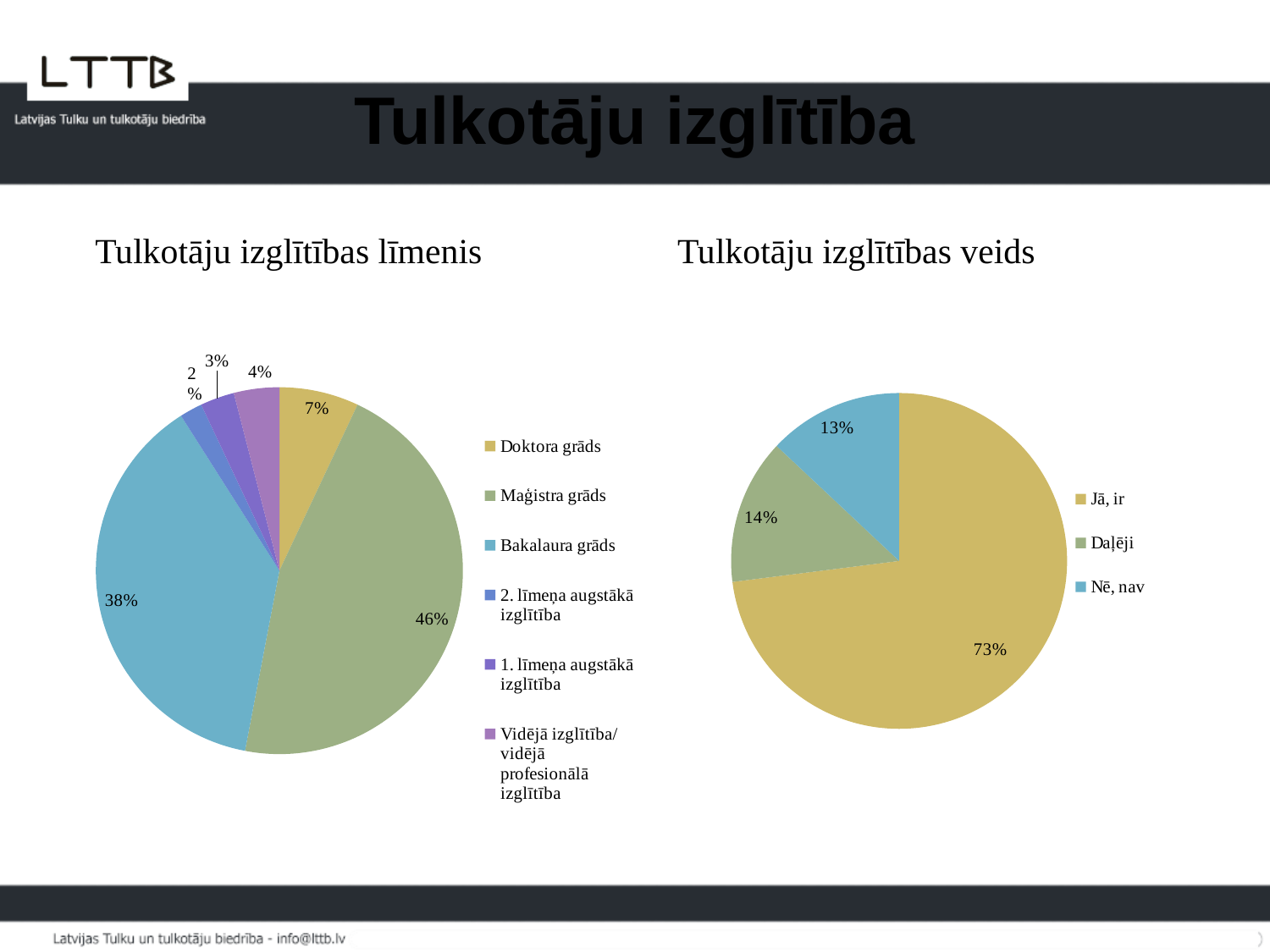
What type of chart is 'Tulkotāju izglītības veids'? Pie chart In the 'Tulkotāju izglītības līmenis' chart, what share is Maģistra grāds? 46% In the 'Tulkotāju izglītības veids' chart, which category has the smallest slice? Nē, nav In the 'Tulkotāju izglītības līmenis' chart, what share is Bakalaura grāds? 38% How many slices does the 'Tulkotāju izglītības līmenis' pie chart have? 6 In the 'Tulkotāju izglītības veids' chart, what share is 'Jā, ir'? 73% In the 'Tulkotāju izglītības veids' chart, what is the difference between 'Jā, ir' and 'Daļēji'? 59% In the 'Tulkotāju izglītības līmenis' chart, which category has the largest slice? Maģistra grāds In the 'Tulkotāju izglītības līmenis' chart, what share is Doktora grāds? 7% In the 'Tulkotāju izglītības līmenis' chart, which category has the smallest slice? 2. līmeņa augstākā izglītība In the 'Tulkotāju izglītības veids' chart, what share is 'Daļēji'? 14% In the 'Tulkotāju izglītības līmenis' chart, what is the difference between Maģistra grāds and Bakalaura grāds? 8%